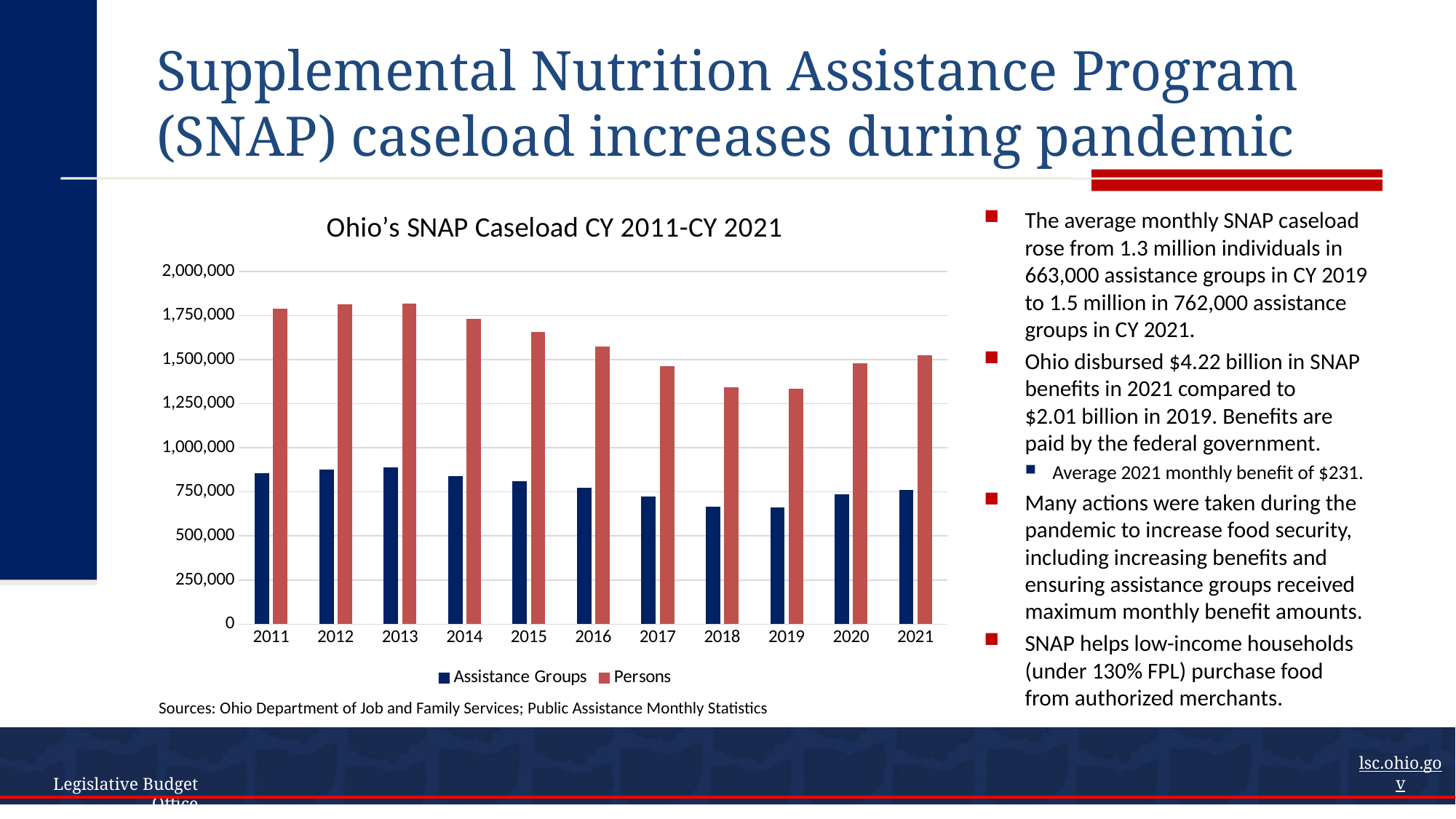
Is the value for Assistance Groups in 2013 greater or less than 750,000? greater Is the value for Persons in 2017 greater or less than 1,500,000? less How many series does the chart's legend list? 2 Do the values for Persons rise or fall from 2013 to 2019? fall Is the value for Persons in 2011 greater or less than 1,750,000? greater Which series is shown in red in the chart? Persons How many years are shown on the x axis of the chart? 11 What is the title of the chart? Ohio's SNAP Caseload CY 2011-CY 2021 What kind of chart is shown on the slide? Bar chart Which year has the larger value for Persons, 2019 or 2021? 2021 Which year has the larger value for Assistance Groups, 2011 or 2018? 2011